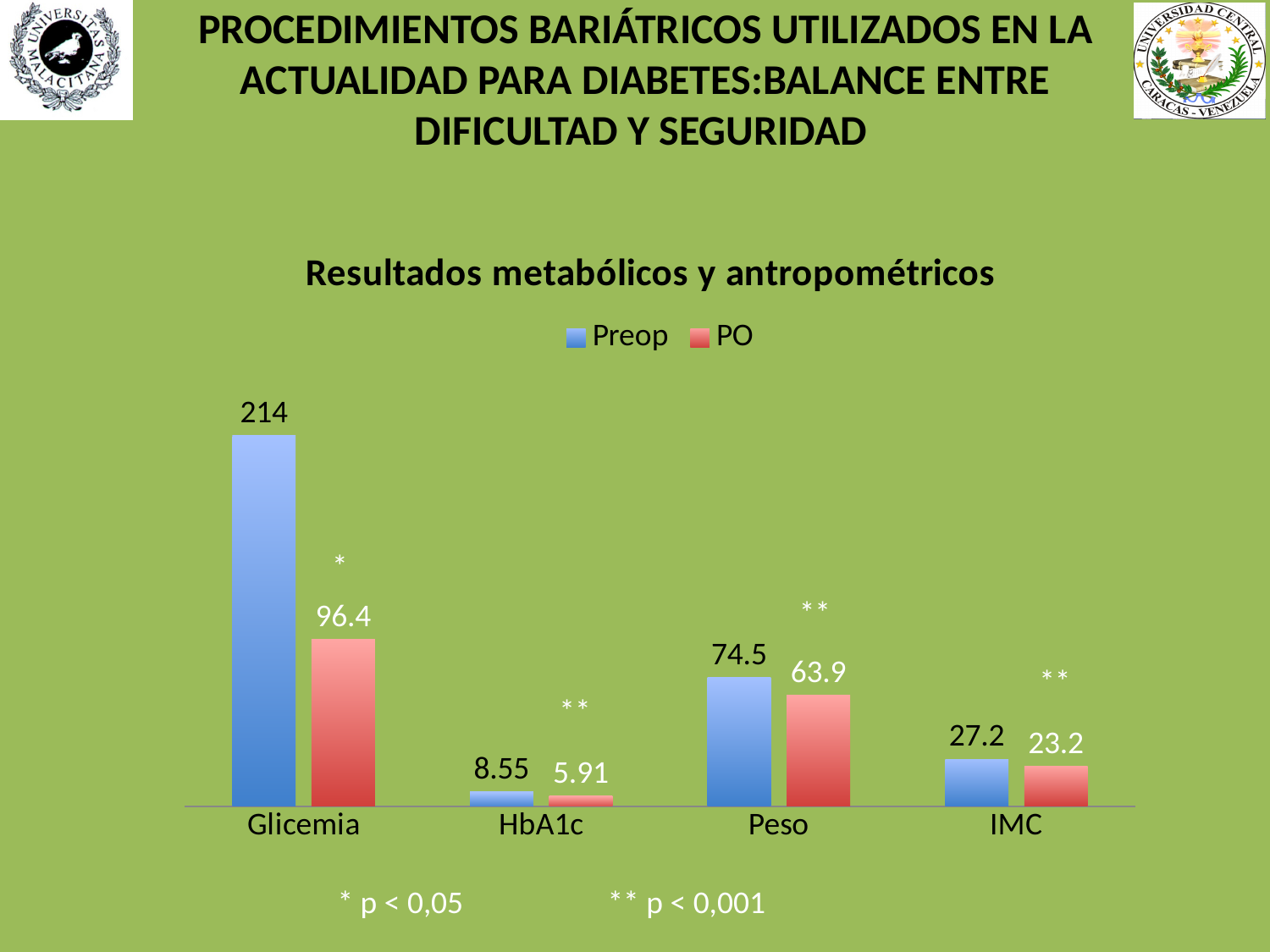
How many categories are shown on the x axis? 4 What is the Preop value for IMC? 27.2 What kind of chart is shown on the slide? Bar chart Which is larger for IMC, the Preop value or the PO value? Preop How many series does the legend list? 2 What is the Preop value for Glicemia? 214 What is the difference between the Preop and PO values for Glicemia? 117.6 Which category has the highest Preop value? Glicemia What is the difference between the Preop and PO values for Peso? 10.6 What is the PO value for HbA1c? 5.91 Which category has the lowest PO value? HbA1c What is the PO value for Peso? 63.9